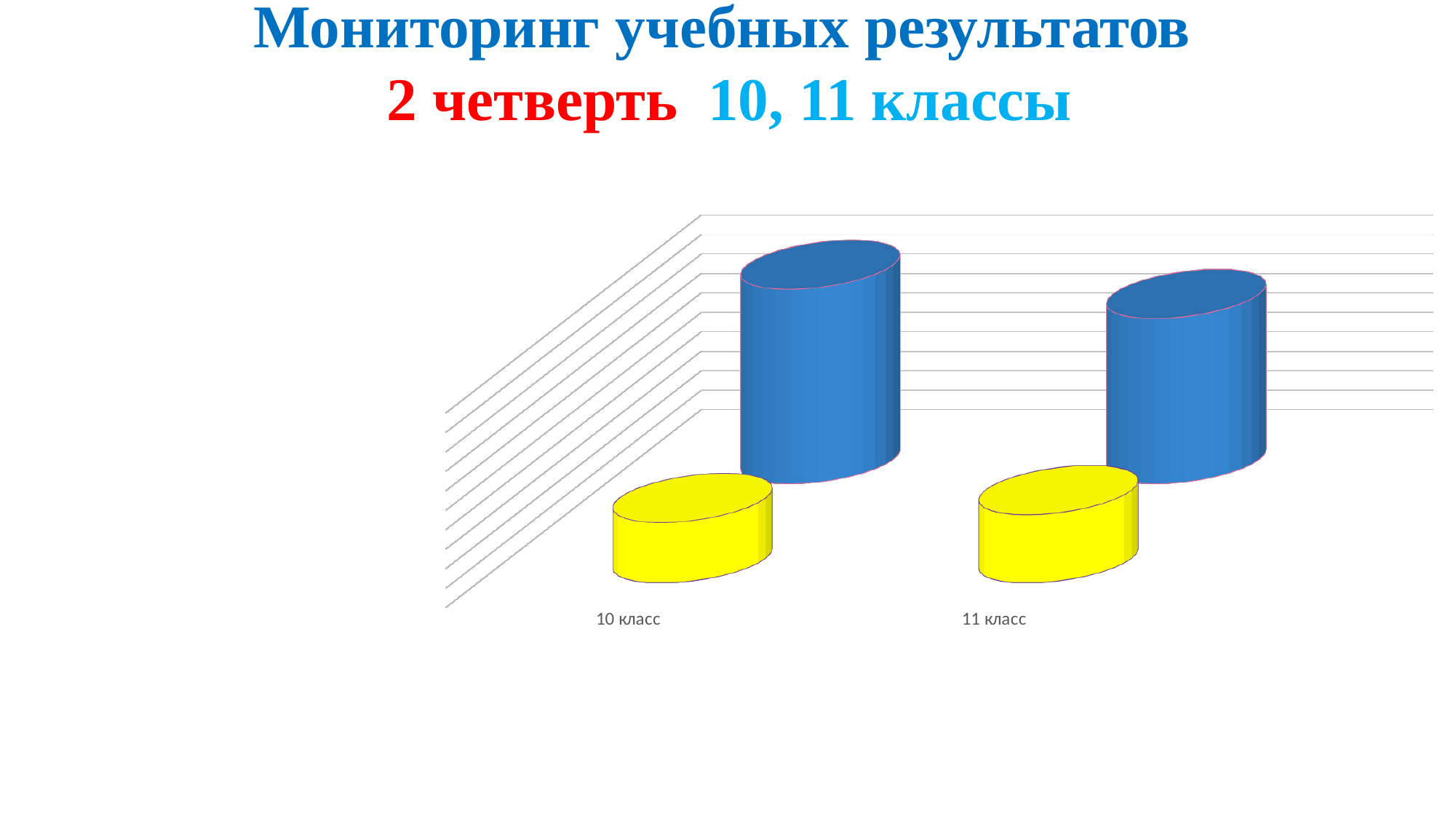
What kind of chart is shown on the slide? bar chart How many categories are shown on the x axis of the chart? 2 For 11 класс, which bar is taller, the blue one or the yellow one? blue How many bars are plotted in the chart in total? 4 What colours are the two series of bars in the chart? blue and yellow Which category has the tallest blue bar in the chart? 10 класс Does the blue series rise or fall from 10 класс to 11 класс? fall Which category has the shortest blue bar in the chart? 11 класс What are the category labels on the x axis of the chart? 10 класс, 11 класс For 10 класс, which bar is taller, the blue one or the yellow one? blue Which category has the taller blue bar, 10 класс or 11 класс? 10 класс